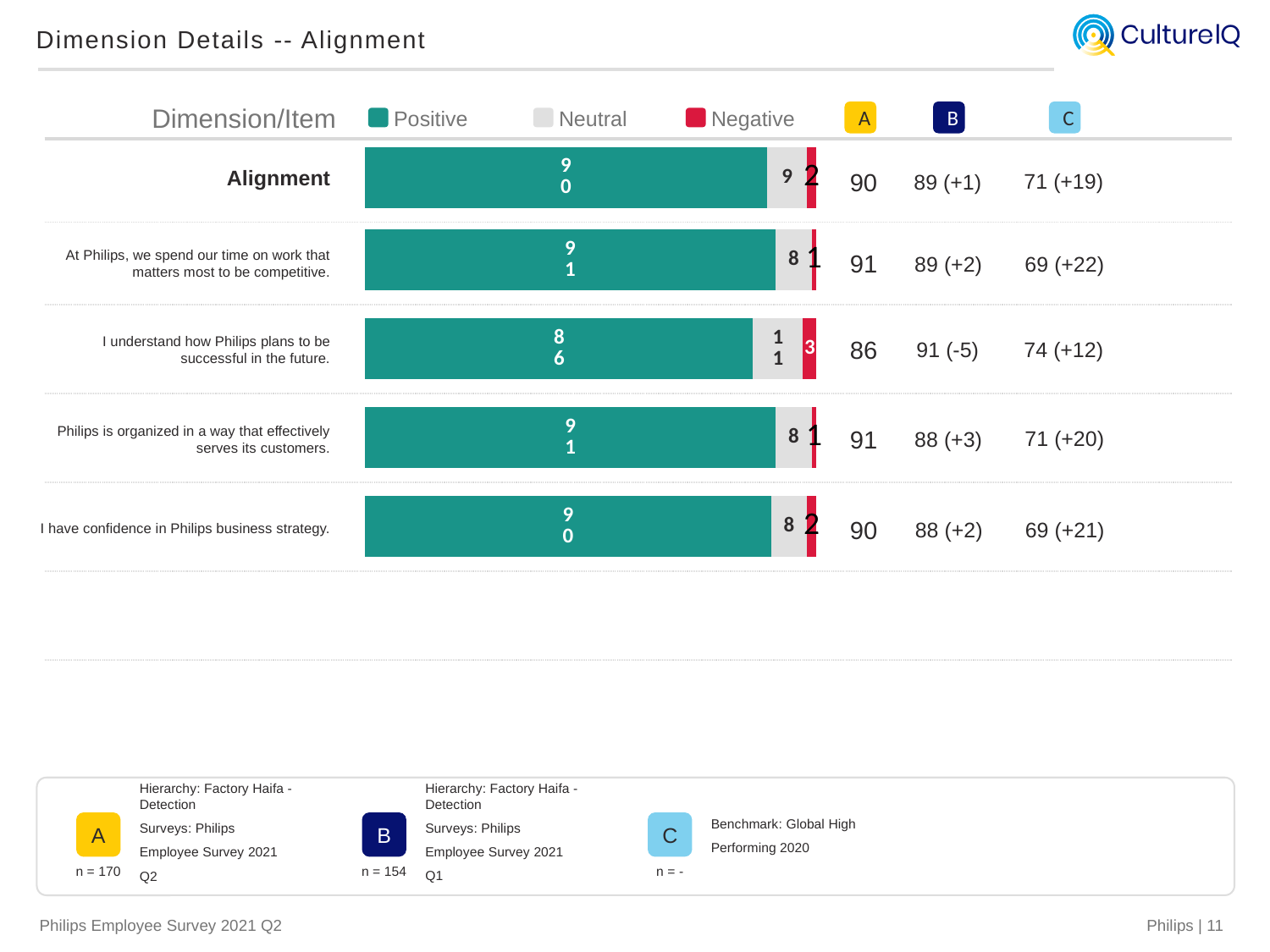
What is the difference between the Positive values for "At Philips, we spend our time on work that matters most to be competitive." and "I understand how Philips plans to be successful in the future."? 5 What kind of chart is shown on the slide? Stacked bar chart Is the Positive value larger for "Philips is organized in a way that effectively serves its customers." or for "I have confidence in Philips business strategy."? Philips is organized in a way that effectively serves its customers. Which item has the lowest Positive value? I understand how Philips plans to be successful in the future. How many rows (dimension/items) are plotted in the chart? 5 What is the Positive value for the Alignment dimension? 90 How many series does the legend list? 3 What is the Negative value for "I have confidence in Philips business strategy."? 2 Which item has the highest Negative value? I understand how Philips plans to be successful in the future. Which colour represents the Negative series in the legend? Red What is the total of the stacked bar for "I understand how Philips plans to be successful in the future."? 100 What is the Neutral value for "I understand how Philips plans to be successful in the future."? 11